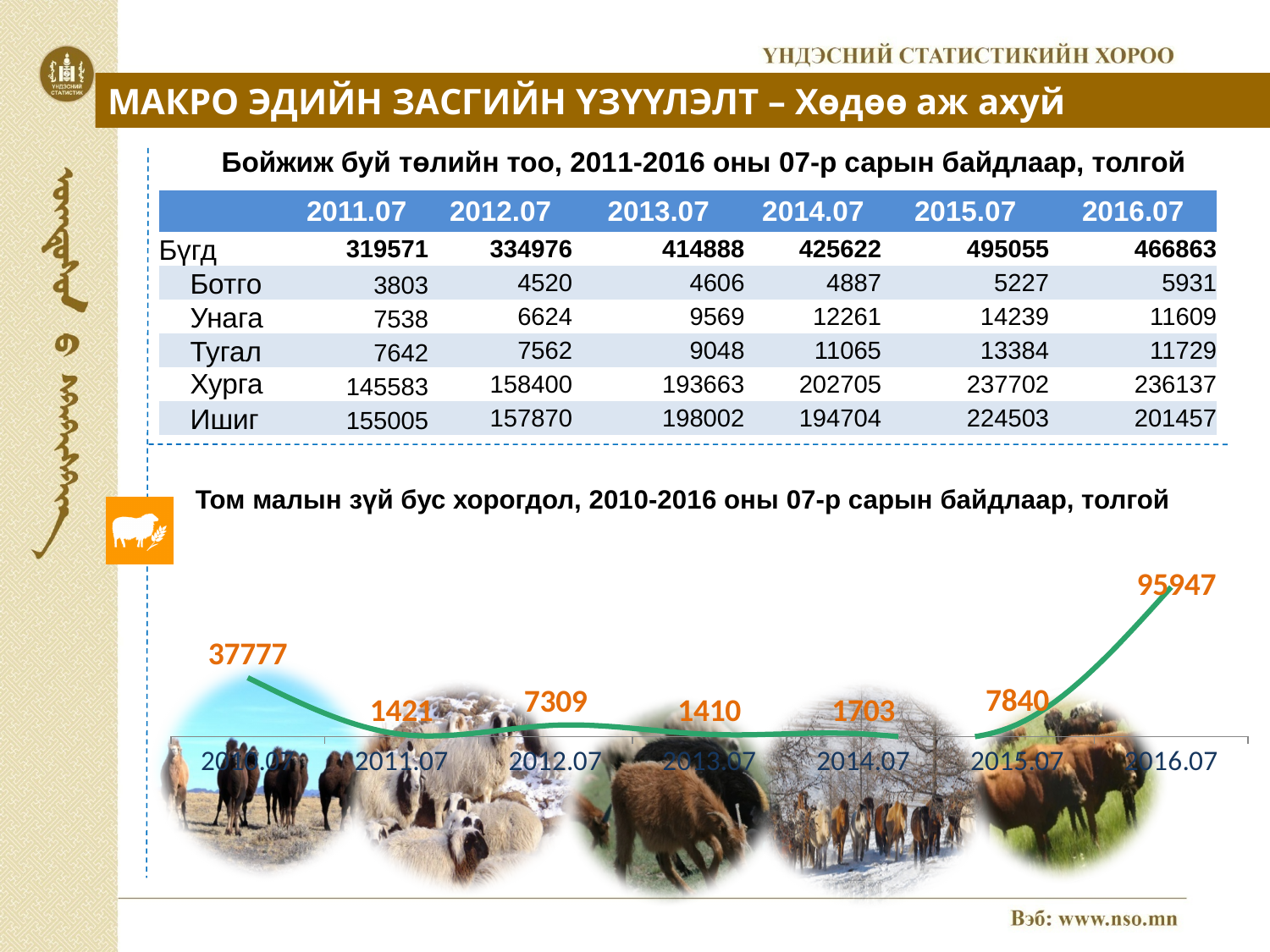
How many data points are plotted in the line chart 'Том малын зүй бус хорогдол'? 7 In the line chart 'Том малын зүй бус хорогдол', what is the value for 2015.07? 7840 In the line chart 'Том малын зүй бус хорогдол', which is larger, the value for 2011.07 or the value for 2014.07? 2014.07 In the line chart 'Том малын зүй бус хорогдол', which period has the lowest value? 2013.07 In the line chart 'Том малын зүй бус хорогдол', what is the value for 2010.07? 37777 In the line chart 'Том малын зүй бус хорогдол', what is the value for 2016.07? 95947 In the line chart 'Том малын зүй бус хорогдол', what is the value for 2012.07? 7309 In the line chart 'Том малын зүй бус хорогдол', what is the difference between the values for 2010.07 and 2011.07? 36356 In the line chart 'Том малын зүй бус хорогдол', what is the difference between the values for 2016.07 and 2015.07? 88107 In the line chart 'Том малын зүй бус хорогдол', which period has the highest value? 2016.07 In the line chart 'Том малын зүй бус хорогдол', does the value rise or fall from 2015.07 to 2016.07? rise What kind of chart is shown at the bottom of the slide under the title 'Том малын зүй бус хорогдол'? line chart